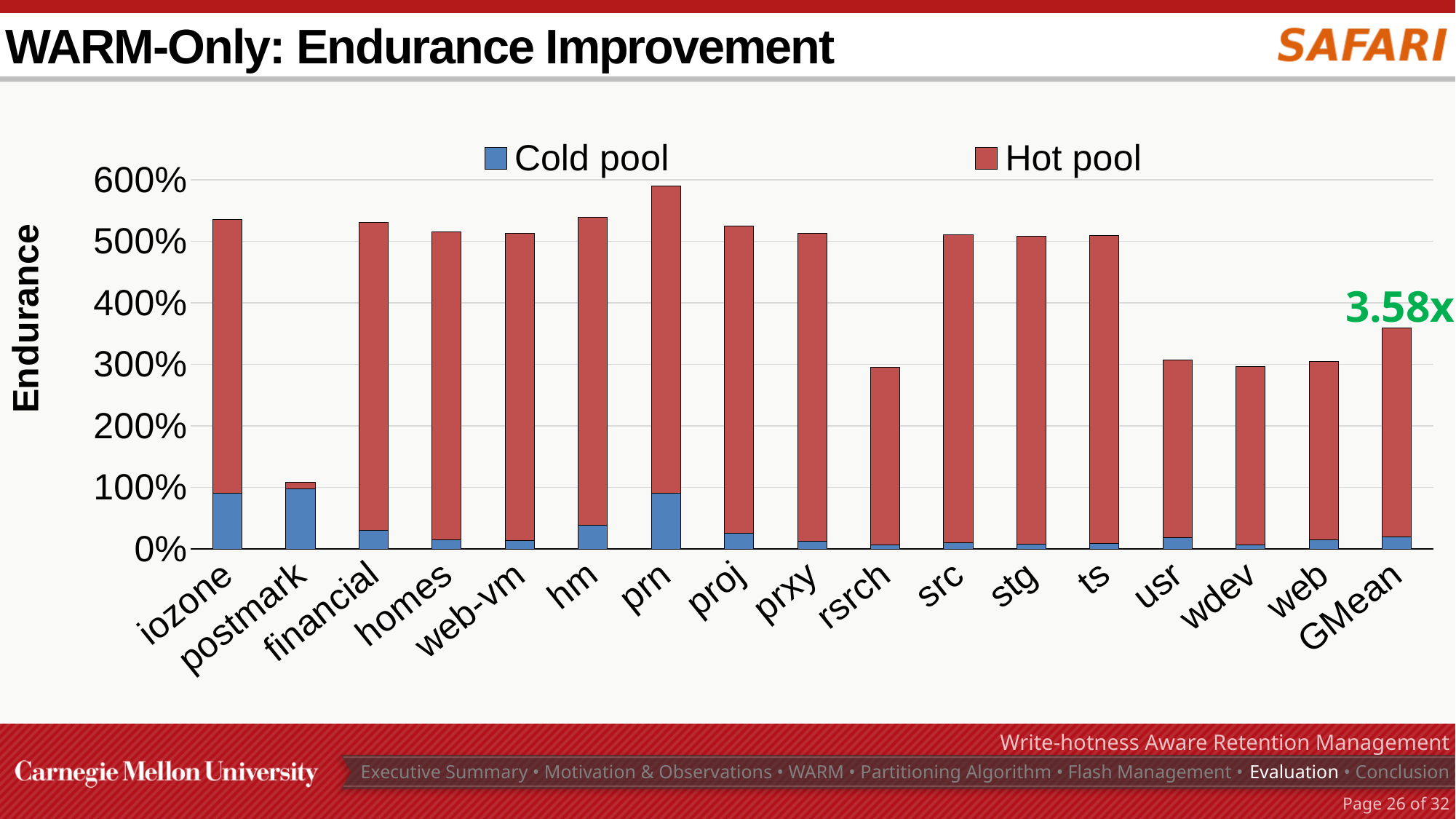
Which category has the shortest stacked bar? postmark How many series does the legend list? 2 What are the two series named in the legend? Cold pool and Hot pool What annotation is printed above the GMean bar? 3.58x Which category has the tallest stacked bar? prn What kind of chart is shown on the slide? stacked bar chart Is the total endurance value for prn greater or less than 500%? greater How many categories are shown along the x axis? 17 Is the total endurance value for postmark greater or less than 200%? less Which has a larger Cold pool segment, postmark or homes? postmark Which has a taller stacked bar, iozone or usr? iozone Is the total endurance value for rsrch greater or less than 400%? less